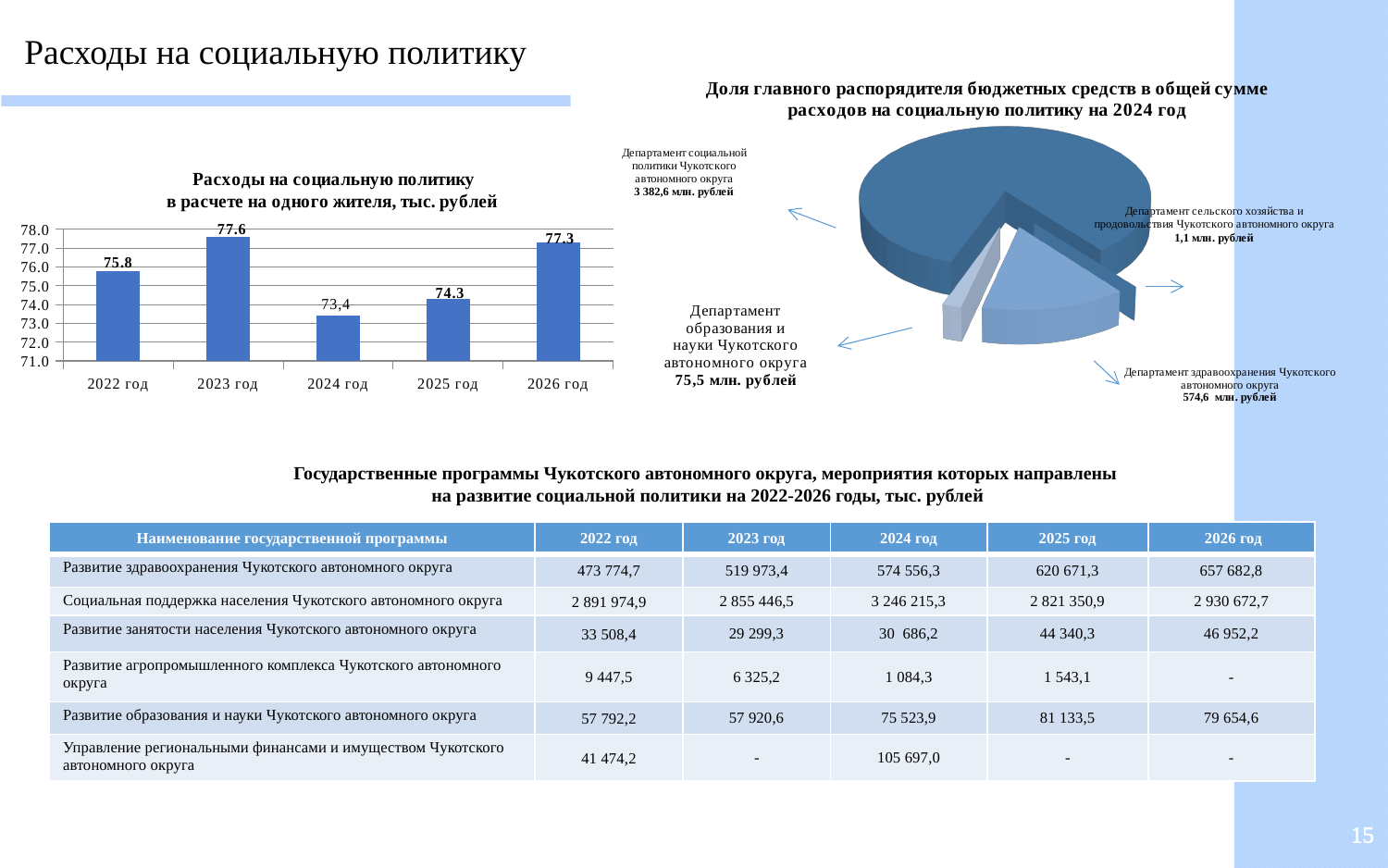
In the pie chart 'Доля главного распорядителя бюджетных средств в общей сумме расходов на социальную политику на 2024 год', what is the value for Департамент здравоохранения Чукотского автономного округа? 574,6 млн. рублей In the pie chart 'Доля главного распорядителя бюджетных средств в общей сумме расходов на социальную политику на 2024 год', which department has the largest share? Департамент социальной политики Чукотского автономного округа In the bar chart 'Расходы на социальную политику в расчете на одного жителя, тыс. рублей', which year has the lowest value? 2024 год What type of chart is 'Доля главного распорядителя бюджетных средств в общей сумме расходов на социальную политику на 2024 год'? Pie chart What type of chart is 'Расходы на социальную политику в расчете на одного жителя, тыс. рублей'? Bar chart In the bar chart 'Расходы на социальную политику в расчете на одного жителя, тыс. рублей', what is the value for 2023 год? 77.6 In the bar chart 'Расходы на социальную политику в расчете на одного жителя, тыс. рублей', which is larger: the value for 2025 год or 2026 год? 2026 год In the pie chart 'Доля главного распорядителя бюджетных средств в общей сумме расходов на социальную политику на 2024 год', what is the value for Департамент образования и науки Чукотского автономного округа? 75,5 млн. рублей In the bar chart 'Расходы на социальную политику в расчете на одного жителя, тыс. рублей', which year has the highest value? 2023 год How many years are shown in the bar chart 'Расходы на социальную политику в расчете на одного жителя, тыс. рублей'? 5 In the bar chart 'Расходы на социальную политику в расчете на одного жителя, тыс. рублей', what is the difference between the values for 2023 год and 2022 год? 1.8 In the bar chart 'Расходы на социальную политику в расчете на одного жителя, тыс. рублей', what is the value for 2024 год? 73,4